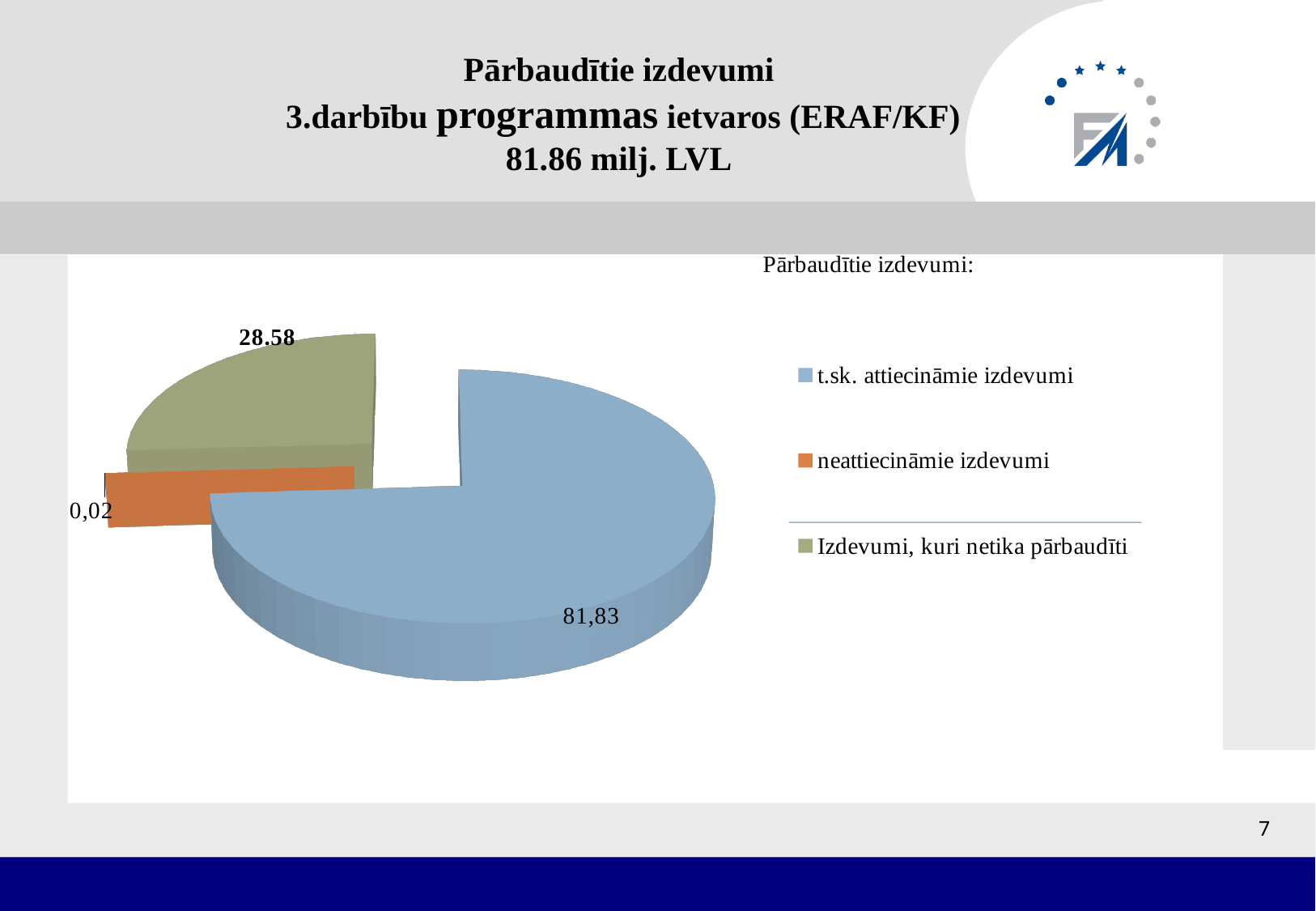
What kind of chart is shown on the slide? pie chart What is the difference between the values for t.sk. attiecināmie izdevumi and Izdevumi, kuri netika pārbaudīti? 53.25 Which category has the smallest slice of the pie? neattiecināmie izdevumi What colour is the slice for Izdevumi, kuri netika pārbaudīti? green Which category has the largest slice of the pie? t.sk. attiecināmie izdevumi How many entries does the legend list? 3 How many slices does the pie chart have? 3 Which is larger, t.sk. attiecināmie izdevumi or Izdevumi, kuri netika pārbaudīti? t.sk. attiecināmie izdevumi What is the value for t.sk. attiecināmie izdevumi? 81,83 What is the value for Izdevumi, kuri netika pārbaudīti? 28.58 What is the value for neattiecināmie izdevumi? 0,02 What is the heading shown above the legend of the chart? Pārbaudītie izdevumi: